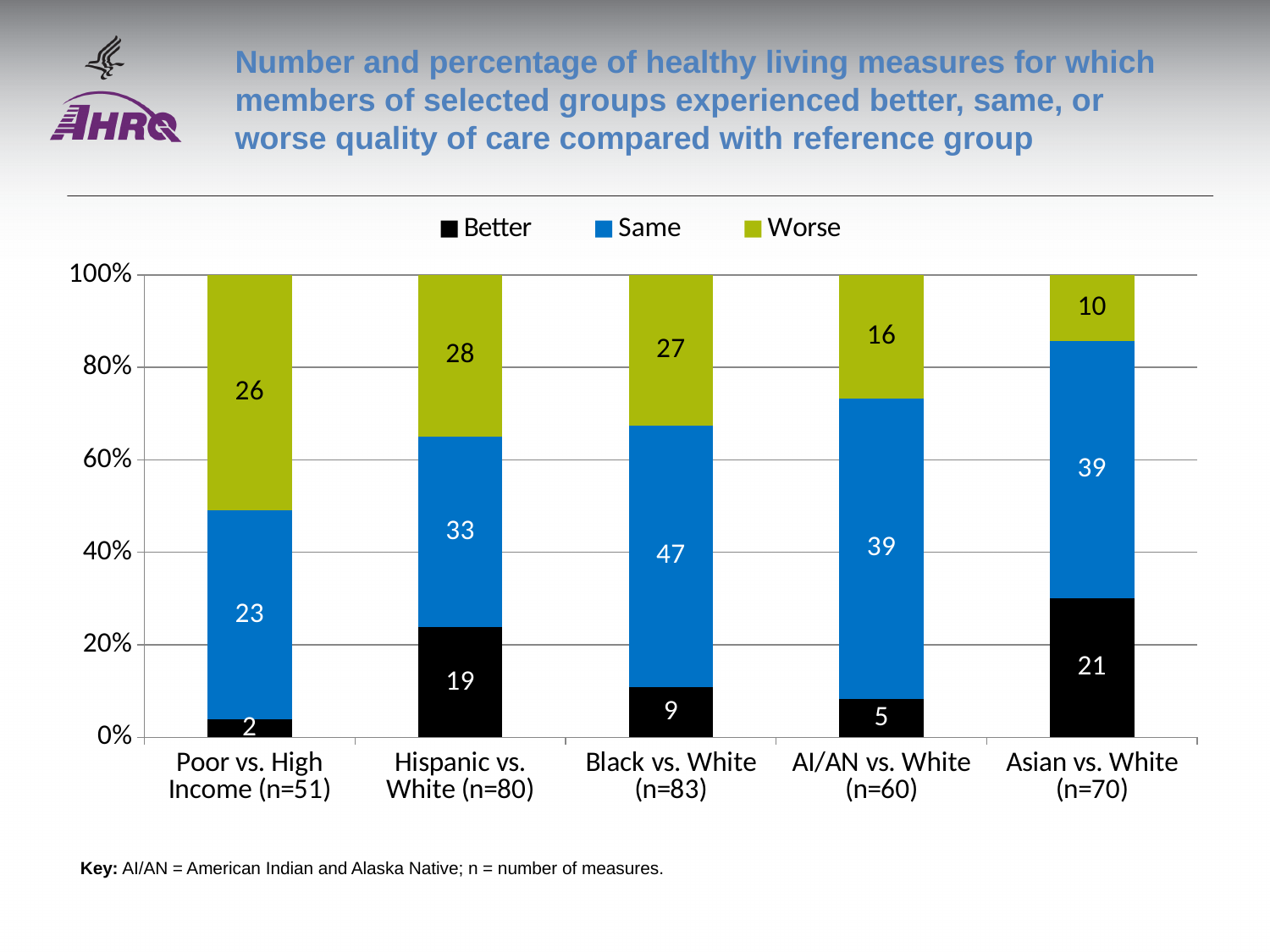
How many groups are shown on the x axis? 5 What kind of chart is this? Stacked bar chart What is the 'Worse' value for Asian vs. White (n=70)? 10 Which colour represents the 'Worse' series? Green What is the 'Better' value for Poor vs. High Income (n=51)? 2 What is the total of the three segments for the Hispanic vs. White bar? 80 Which is larger: the 'Worse' value for Hispanic vs. White or for AI/AN vs. White? Hispanic vs. White What is the difference between the 'Same' values for Black vs. White and Hispanic vs. White? 14 What is the 'Same' value for Black vs. White (n=83)? 47 How many series does the legend list? 3 Which group has the highest 'Better' value? Asian vs. White (n=70) Which group has the lowest 'Worse' value? Asian vs. White (n=70)